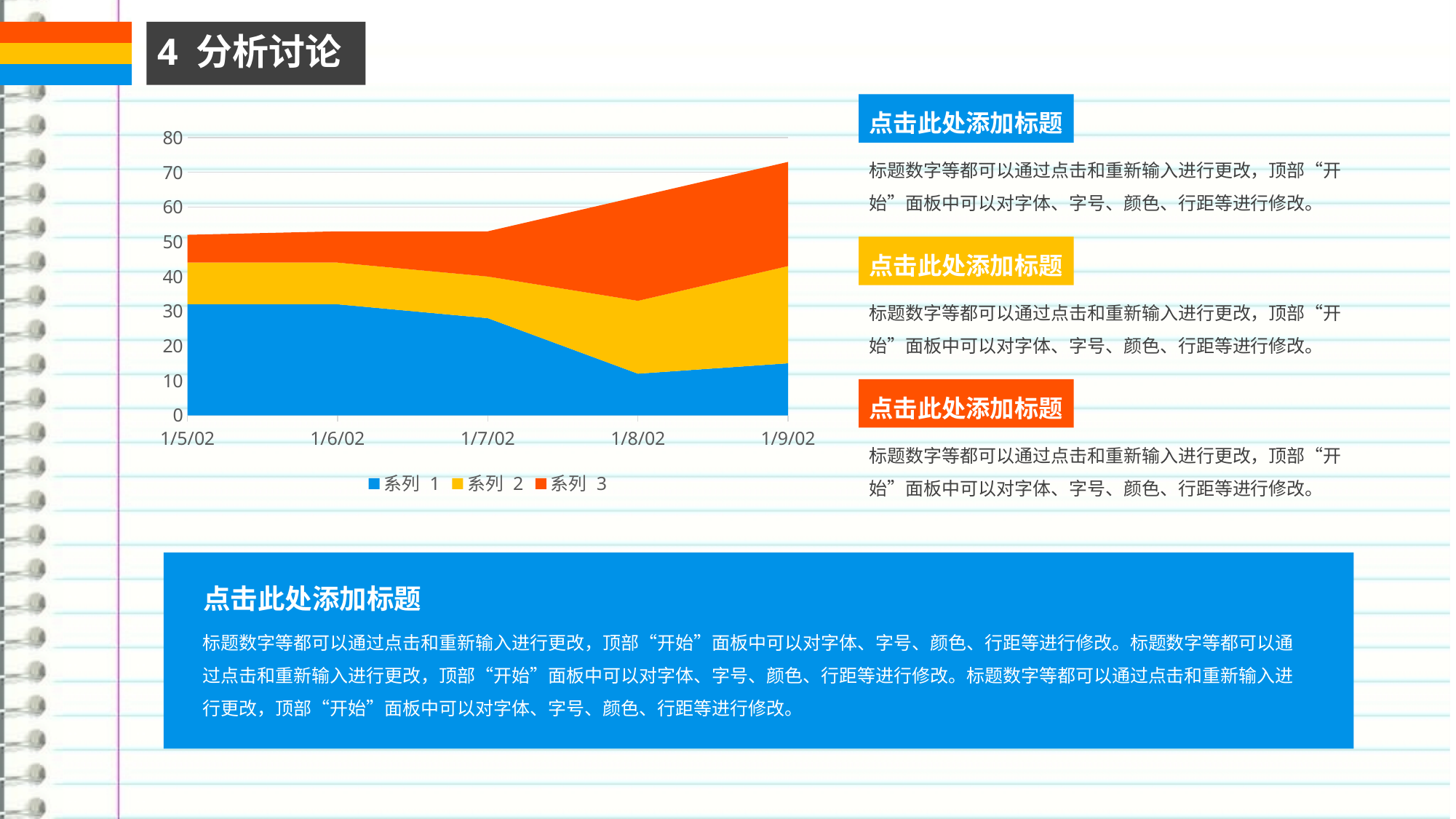
Is the stacked total of all three series at 1/9/02 greater or less than 60? greater How many series does the chart legend list? 3 How many dates are shown along the x axis of the chart? 5 Is the stacked total of all three series at 1/5/02 greater or less than 60? less What are the three legend entries of the chart? 系列 1, 系列 2, 系列 3 Is the value for 系列 1 at 1/9/02 greater or less than 20? less Does the value for 系列 1 rise or fall from 1/5/02 to 1/8/02? fall Does the stacked total of all three series rise or fall from 1/7/02 to 1/9/02? rise What kind of chart is shown on the slide? Stacked area chart Which series is shown in blue in the chart? 系列 1